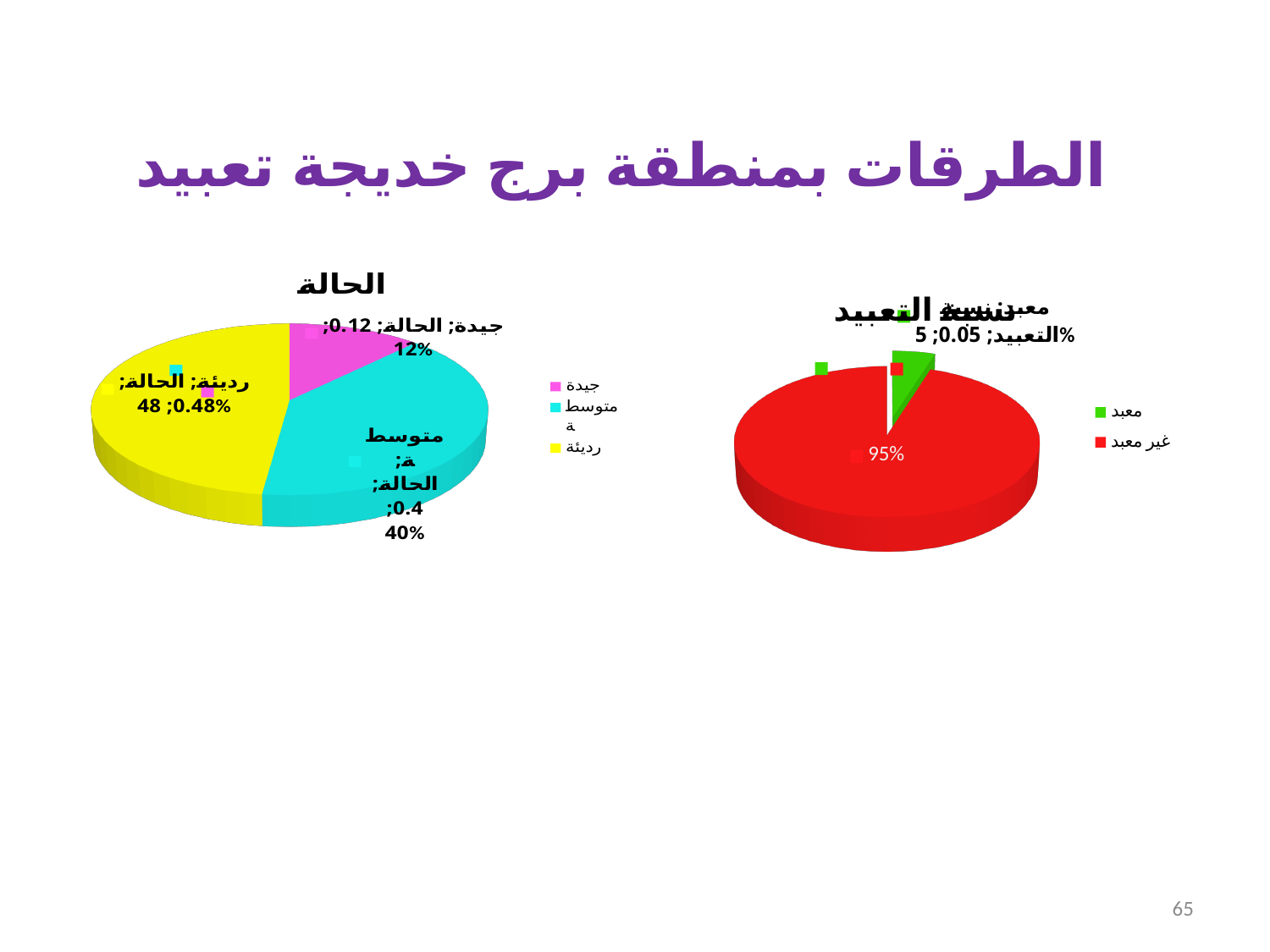
In the left pie chart titled الحالة, which category has the largest share? رديئة In the left pie chart titled الحالة, what is the difference in percentage points between رديئة and متوسطة? 8 In the left pie chart titled الحالة, which category has the smallest share? جيدة In the right pie chart, which is larger, معبد or غير معبد? غير معبد In the left pie chart titled الحالة, what percentage is shown for the رديئة slice? 48% In the right pie chart, what percentage is shown for غير معبد? 95% In the right pie chart, what colour is the غير معبد slice? Red In the left pie chart titled الحالة, what percentage is shown for the جيدة slice? 12% In the left pie chart titled الحالة, what percentage is shown for the متوسطة slice? 40% In the left pie chart titled الحالة, how many slices are there? 3 In the right pie chart, what percentage is shown for معبد? 5% What type of chart is the right chart on the slide? Pie chart